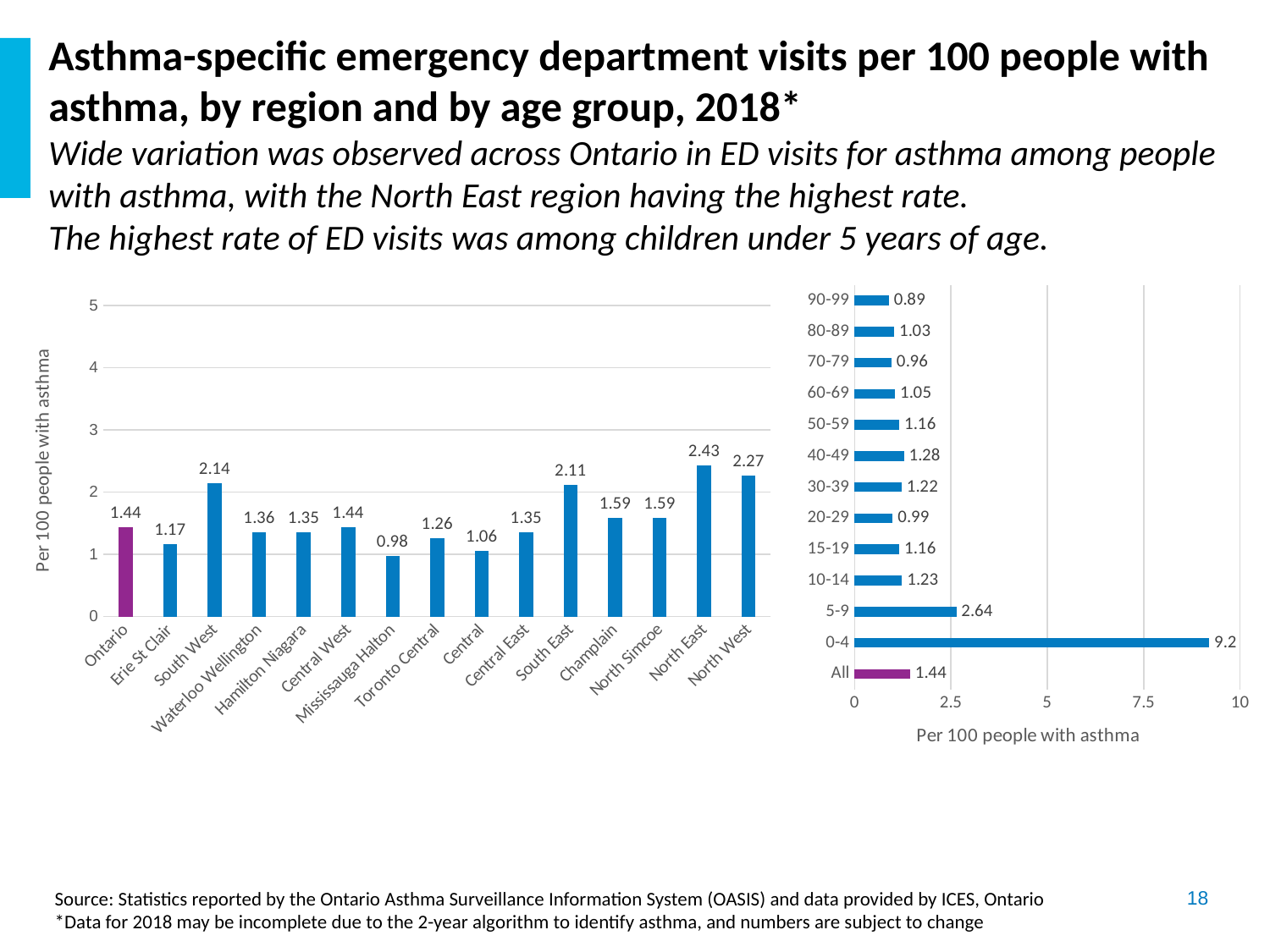
In the left chart (by region), what is the difference between North East and Ontario? 0.99 In the right chart (by age group), what is the value for 0-4? 9.2 In the left chart (by region), which region has the lowest value? Mississauga Halton In the left chart (by region), what is the value for North East? 2.43 In the right chart (by age group), which age group has the lowest value? 90-99 In the left chart (by region), which region has the highest value? North East In the left chart (by region), which is larger, South West or South East? South West In the right chart (by age group), how many age-group categories are shown, including All? 13 In the right chart (by age group), what is the difference between 0-4 and 5-9? 6.56 In the left chart (by region), how many regions (bars) are shown? 15 What kind of chart is the right chart (by age group)? Bar chart In the left chart (by region), what is the value for Mississauga Halton? 0.98